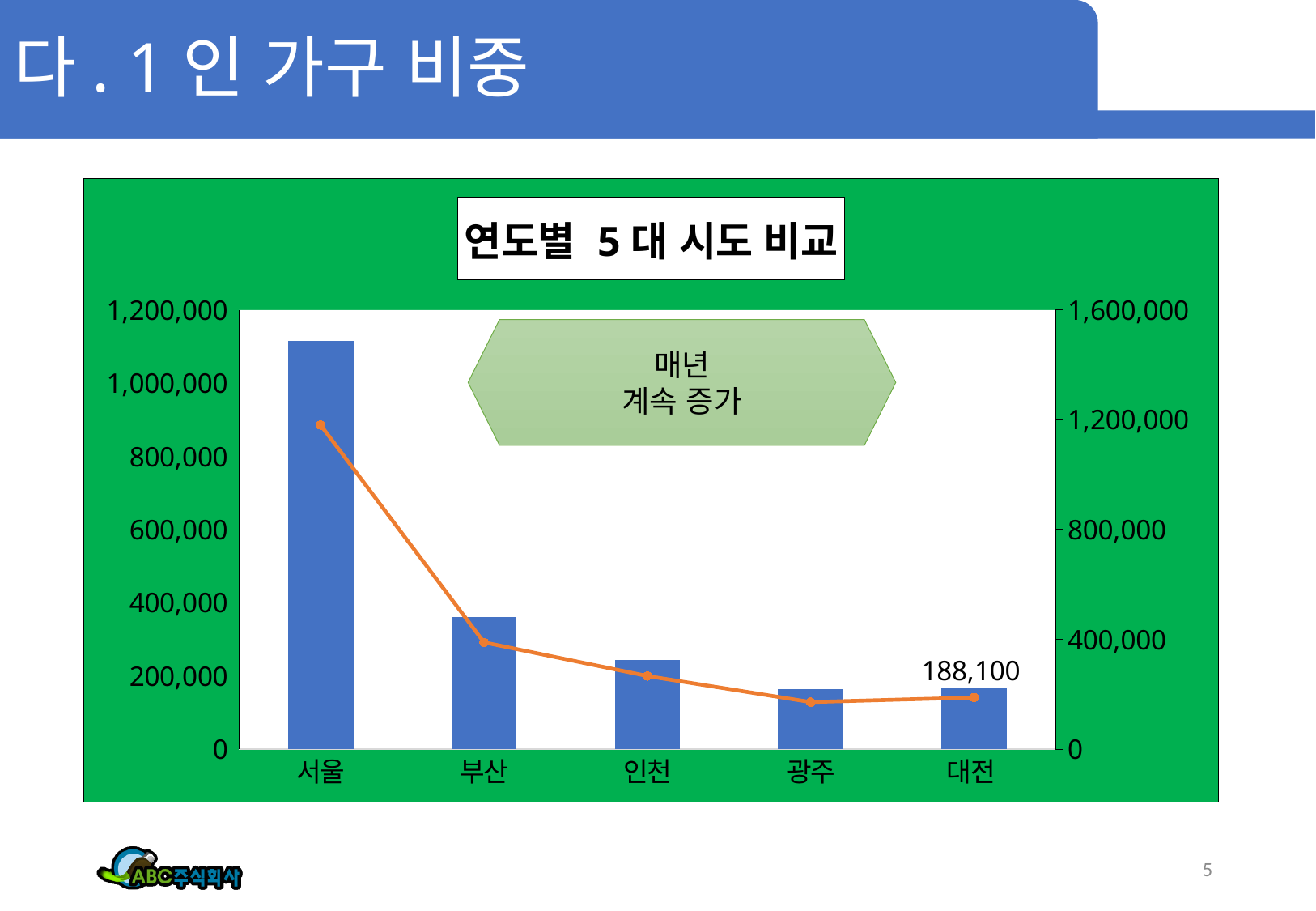
Does the orange line generally rise or fall from 서울 to 광주? fall What kind of chart is shown on the slide? Combination bar and line chart Is the bar value for 인천 greater or less than 200,000 on the left axis? greater Which category has the tallest bar in the chart? 서울 Is the bar value for 부산 greater or less than 400,000 on the left axis? less How many categories are shown on the x axis of the chart? 5 What data label is printed for 대전 in the chart? 188,100 What text is written in the green callout shape inside the chart? 매년 계속 증가 Which has the taller bar, 서울 or 부산? 서울 Which has the taller bar, 부산 or 인천? 부산 Is the bar value for 서울 greater or less than 1,000,000 on the left axis? greater What is the title of the chart? 연도별 5대 시도 비교